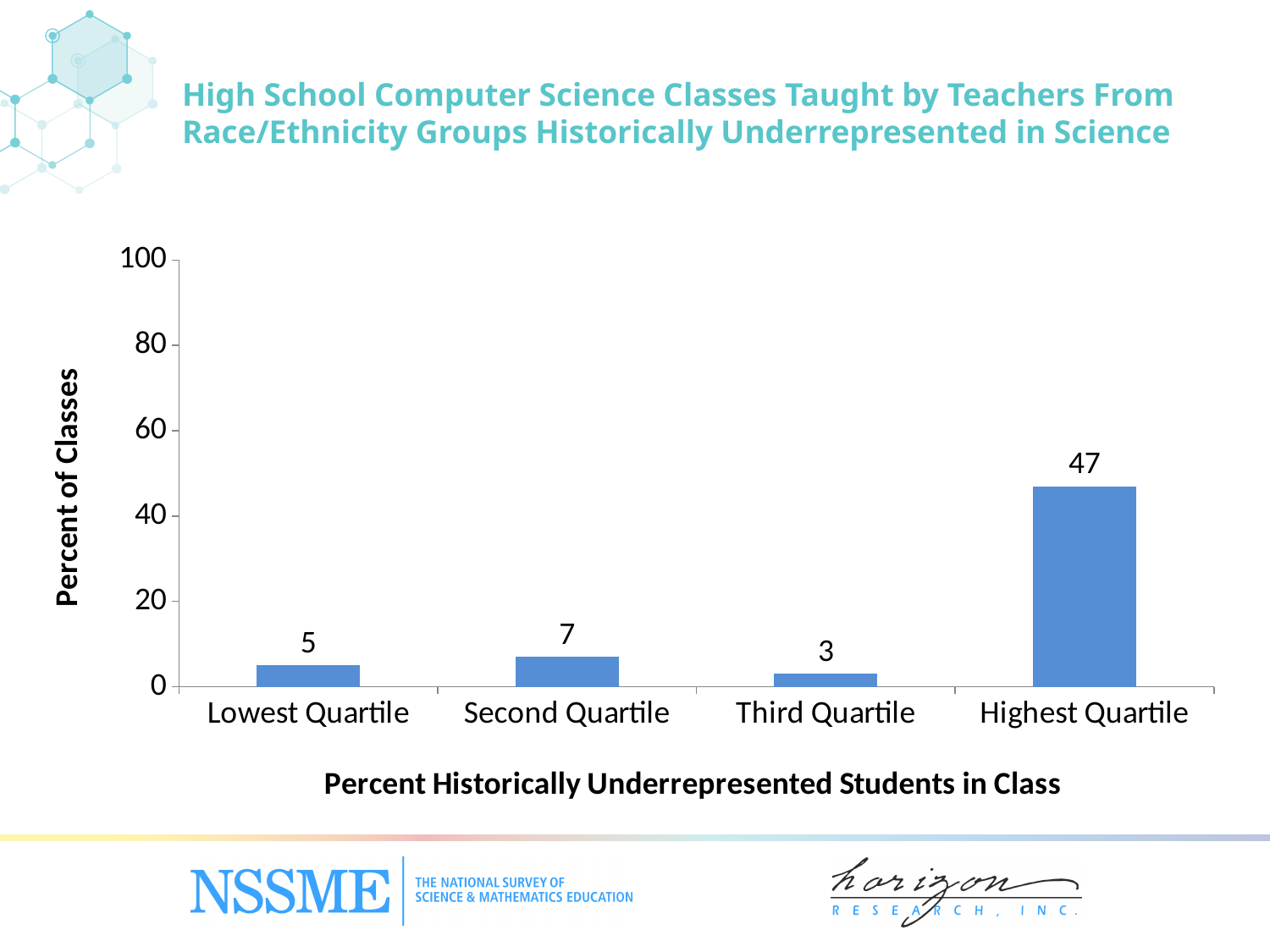
Which category has the highest value? Highest Quartile How many categories are shown on the x axis? 4 What is the value for Third Quartile? 3 What is the value for Lowest Quartile? 5 What is the value for Highest Quartile? 47 Which is larger, the value for Lowest Quartile or the value for Second Quartile? Second Quartile What is the label of the y axis? Percent of Classes What is the value for Second Quartile? 7 What kind of chart is shown on the slide? bar chart Which category has the lowest value? Third Quartile Is the value for Highest Quartile greater or less than 40? greater What is the difference between the values for Highest Quartile and Second Quartile? 40